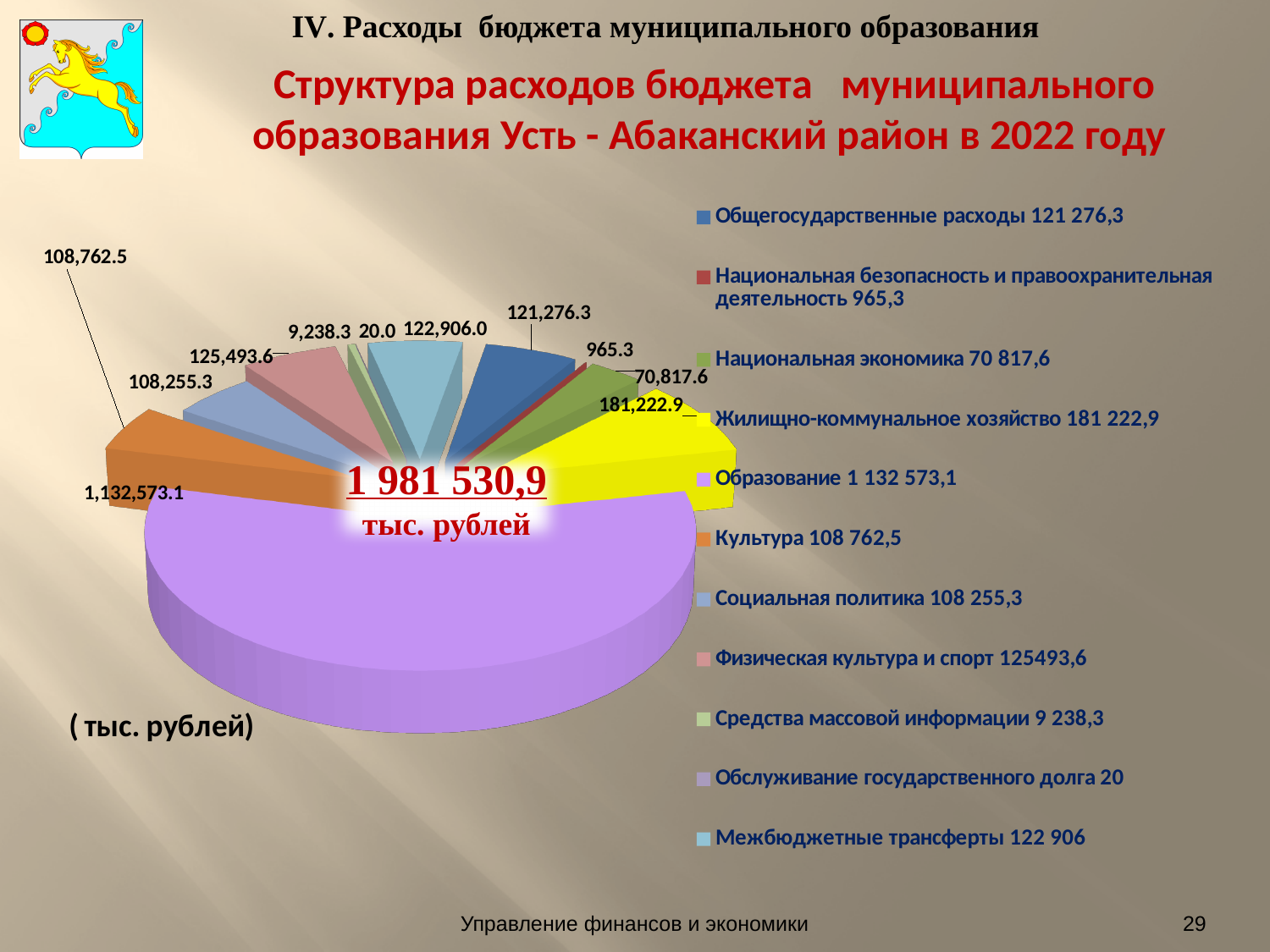
Which category has the largest slice of the pie? Образование What is the value for Обслуживание государственного долга? 20.0 What is the value for Жилищно-коммунальное хозяйство on the pie chart? 181,222.9 What total amount is printed in the centre of the pie chart? 1 981 530,9 тыс. рублей Which is larger: Национальная экономика or Межбюджетные трансферты? Межбюджетные трансферты What is the value for Национальная безопасность и правоохранительная деятельность? 965.3 What is the value for Образование on the pie chart? 1,132,573.1 What is the difference between Жилищно-коммунальное хозяйство and Общегосударственные расходы? 59,946.6 What type of chart is shown on the slide? pie chart What unit is indicated below the pie chart? тыс. рублей Which category has the smallest value on the pie chart? Обслуживание государственного долга How many categories are shown in the pie chart? 11